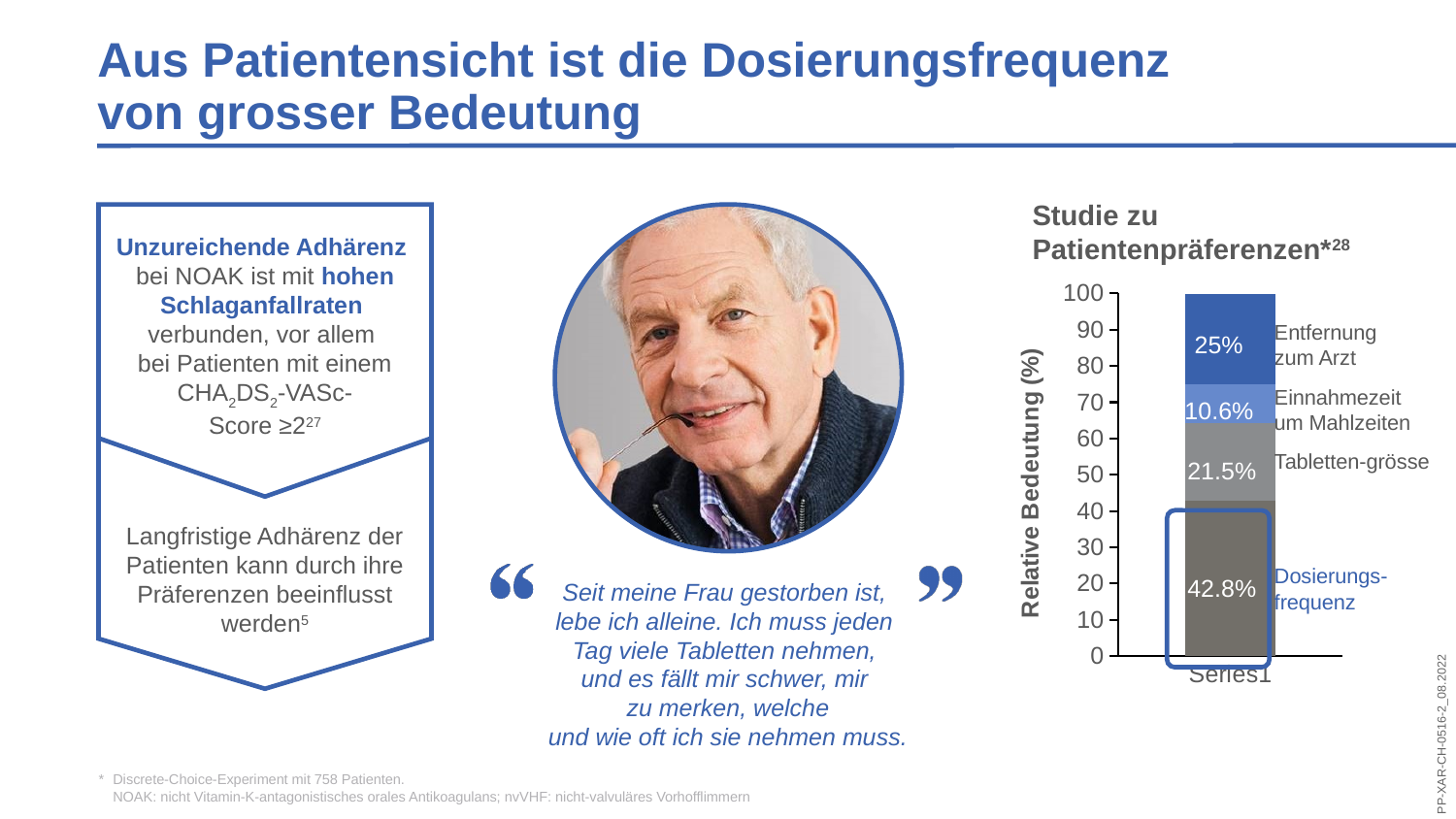
What is the value for Entfernung zum Arzt in the chart? 25% What kind of chart is shown on the slide? stacked bar chart What is the label of the y axis of the chart? Relative Bedeutung (%) What is the difference between the values for Dosierungsfrequenz and Tabletten-grösse? 21.3% How many segments make up the stacked bar in the chart? 4 What is the value for Tabletten-grösse in the chart? 21.5% What is the difference between the values for Entfernung zum Arzt and Einnahmezeit um Mahlzeiten? 14.4% Which is larger, the value for Entfernung zum Arzt or the value for Tabletten-grösse? Entfernung zum Arzt Which segment of the stacked bar has the highest value? Dosierungsfrequenz What is the value for Einnahmezeit um Mahlzeiten in the chart? 10.6% What is the value for Dosierungsfrequenz in the chart? 42.8% Which segment of the stacked bar has the lowest value? Einnahmezeit um Mahlzeiten